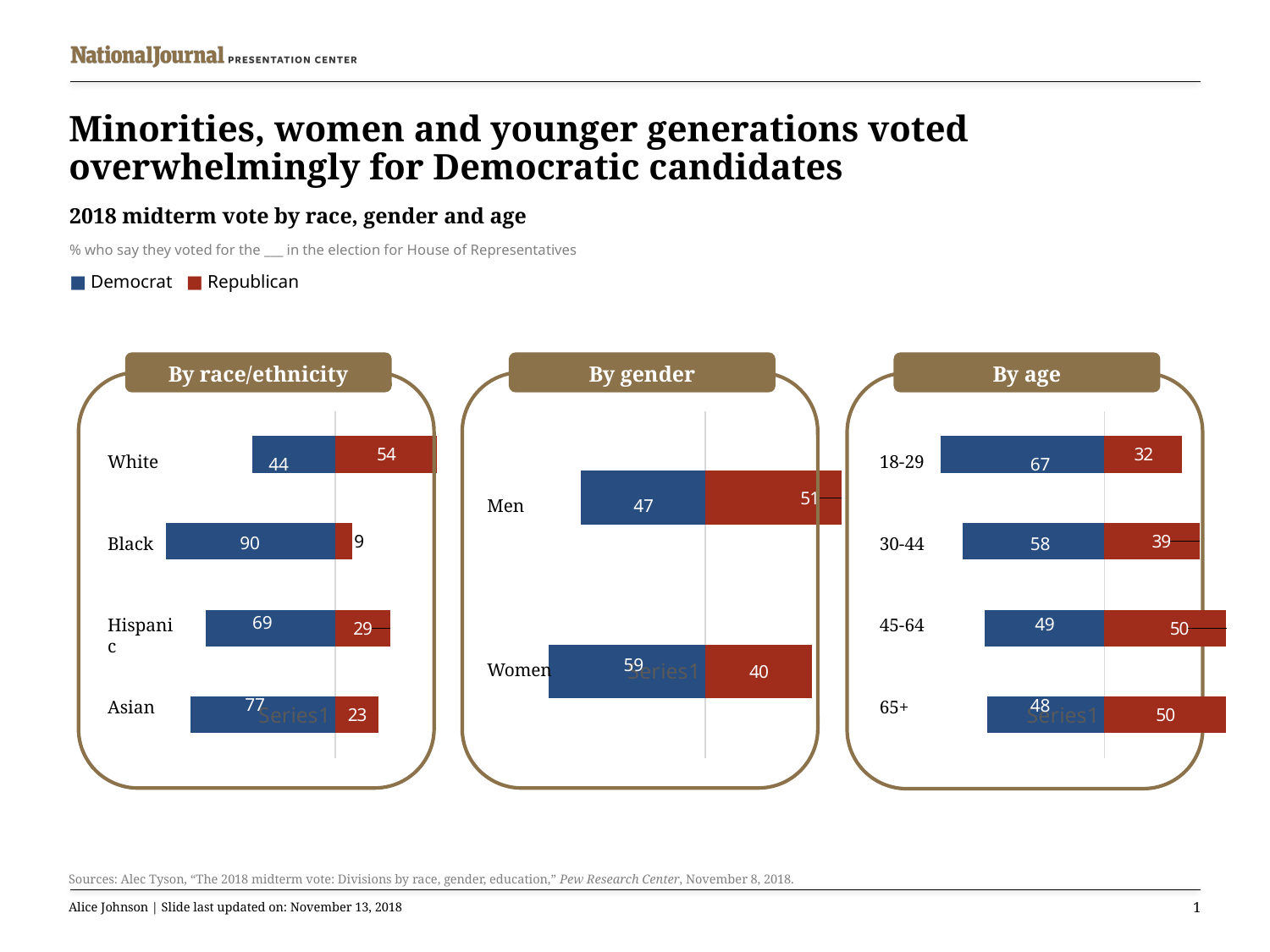
In the 'By gender' chart, what is the Republican value for Men? 51 How many age groups are shown in the 'By age' chart? 4 In the 'By age' chart, what is the Democrat value for the 18-29 group? 67 In the 'By race/ethnicity' chart, which group has the highest Democrat value? Black In the 'By race/ethnicity' chart, which group has the lowest Republican value? Black In the 'By race/ethnicity' chart, what percentage of Black voters say they voted for the Democrat? 90 In the 'By age' chart, do the Democrat values rise or fall from the 18-29 group to the 65+ group? Fall In the 'By race/ethnicity' chart, what is the Republican value for Hispanic voters? 29 In the 'By age' chart, for the 45-64 group, is the Democrat or the Republican value larger? Republican In the 'By gender' chart, what is the difference between the Democrat and Republican values for Women? 19 How many series does the legend list? 2 What kind of chart is the 'By gender' chart? Bar chart